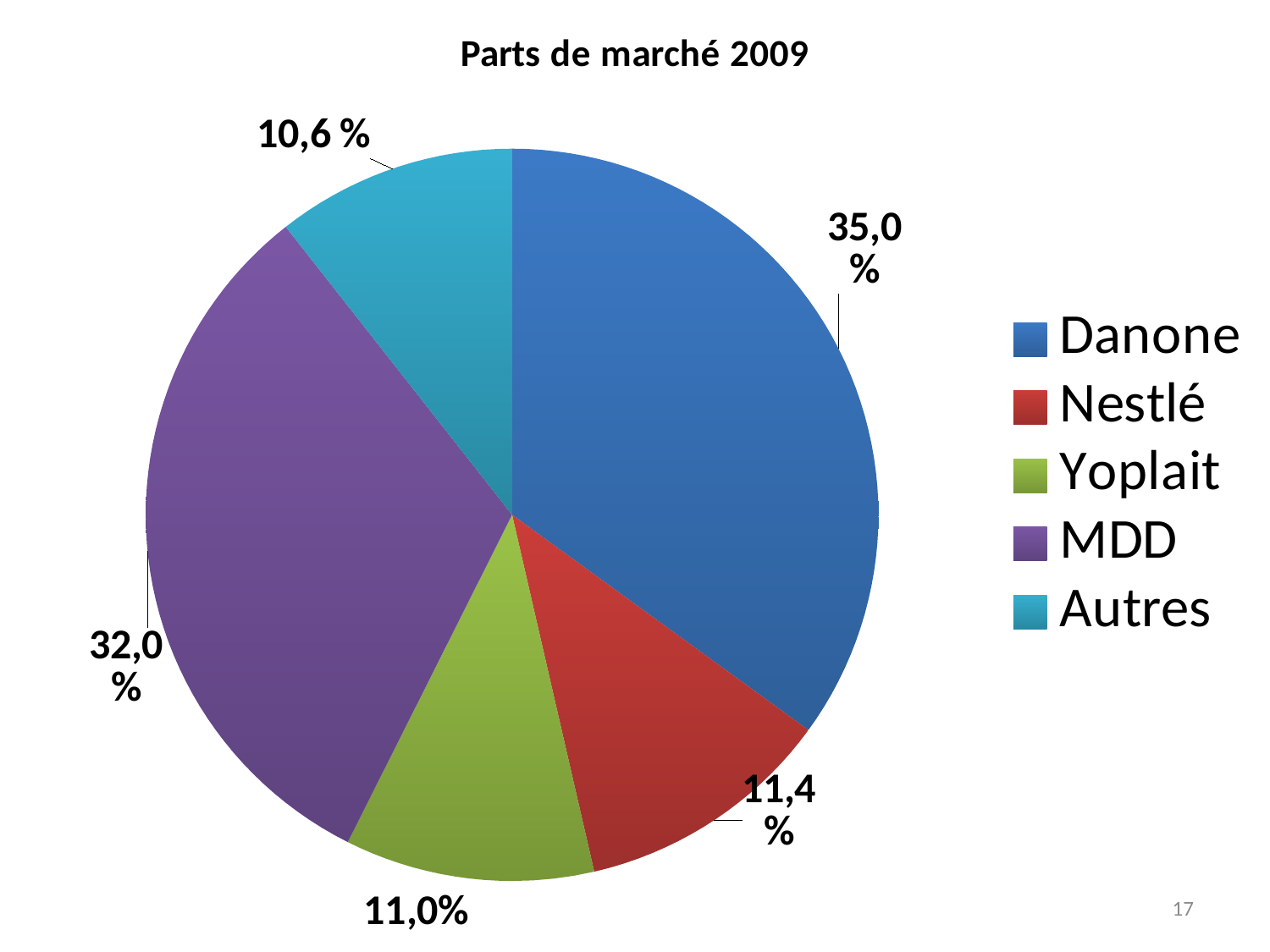
What is the market share shown for Yoplait? 11,0% What is the market share shown for Danone? 35,0 % What is the market share shown for Nestlé? 11,4 % What is the market share shown for MDD? 32,0 % Which category has the largest slice of the pie? Danone Which category has the smallest slice of the pie? Autres What type of chart is shown on the slide? Pie chart What is the title of the chart? Parts de marché 2009 What is the difference between the shares of Danone and MDD? 3,0 % How many categories are shown in the pie chart? 5 Which has the larger share, Danone or MDD? Danone What is the market share shown for Autres? 10,6 %